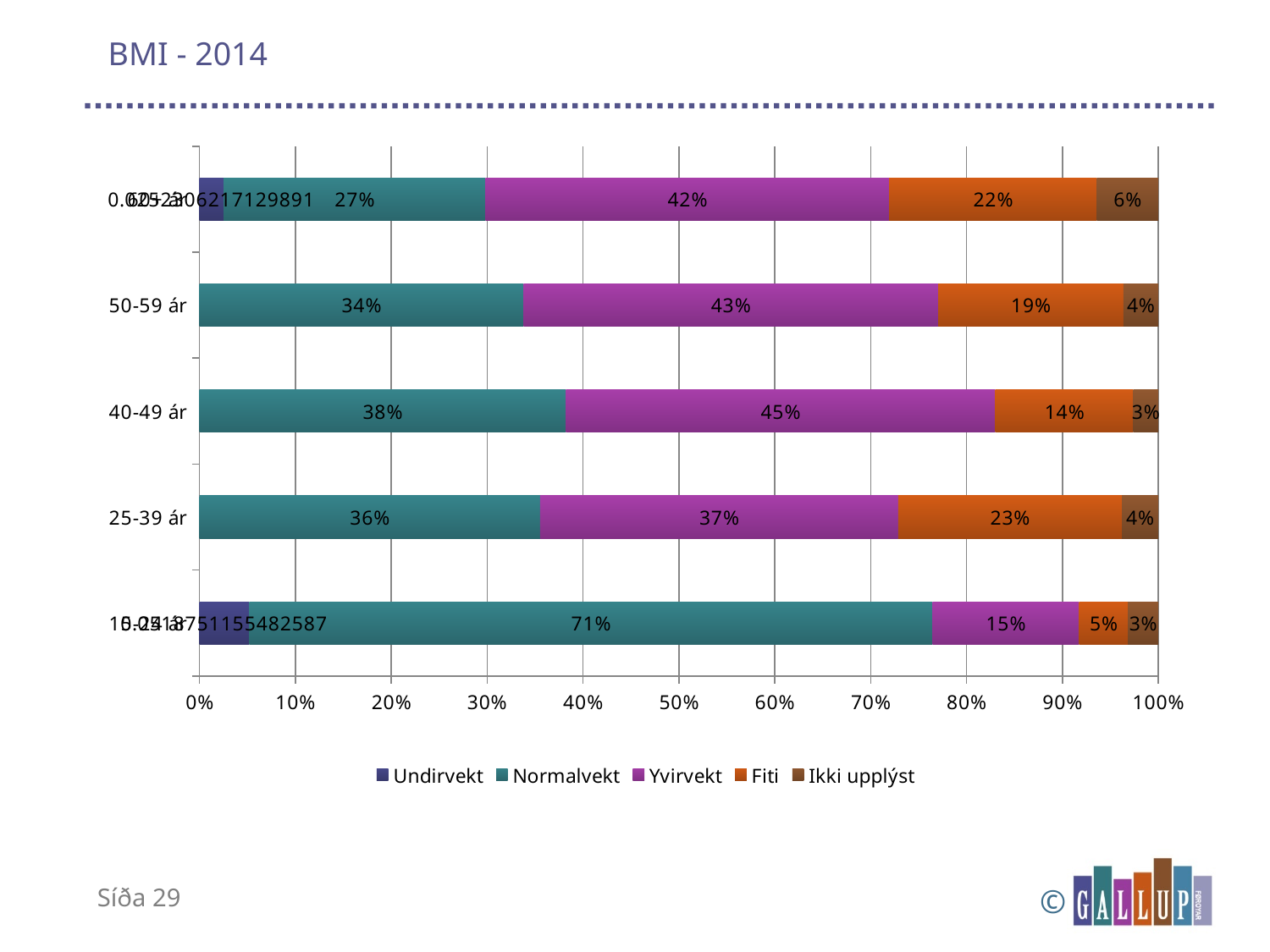
What is the Normalvekt value for the bottom bar of the chart? 71% What is the Fiti value for the 25-39 ár group? 23% What is the Normalvekt value for the 50-59 ár group? 34% What is the Yvirvekt value for the 40-49 ár group? 45% Which age group has the highest Yvirvekt value? 40-49 ár What is the difference between the Normalvekt values for 40-49 ár and 50-59 ár? 4 percentage points How many series does the legend list? 5 What is the first entry in the chart legend? Undirvekt How many age-group categories are plotted on the chart? 5 What kind of chart is shown on the slide? Stacked bar chart What is the Ikki upplýst value for the 50-59 ár group? 4% Which has the larger Fiti value, 25-39 ár or 40-49 ár? 25-39 ár